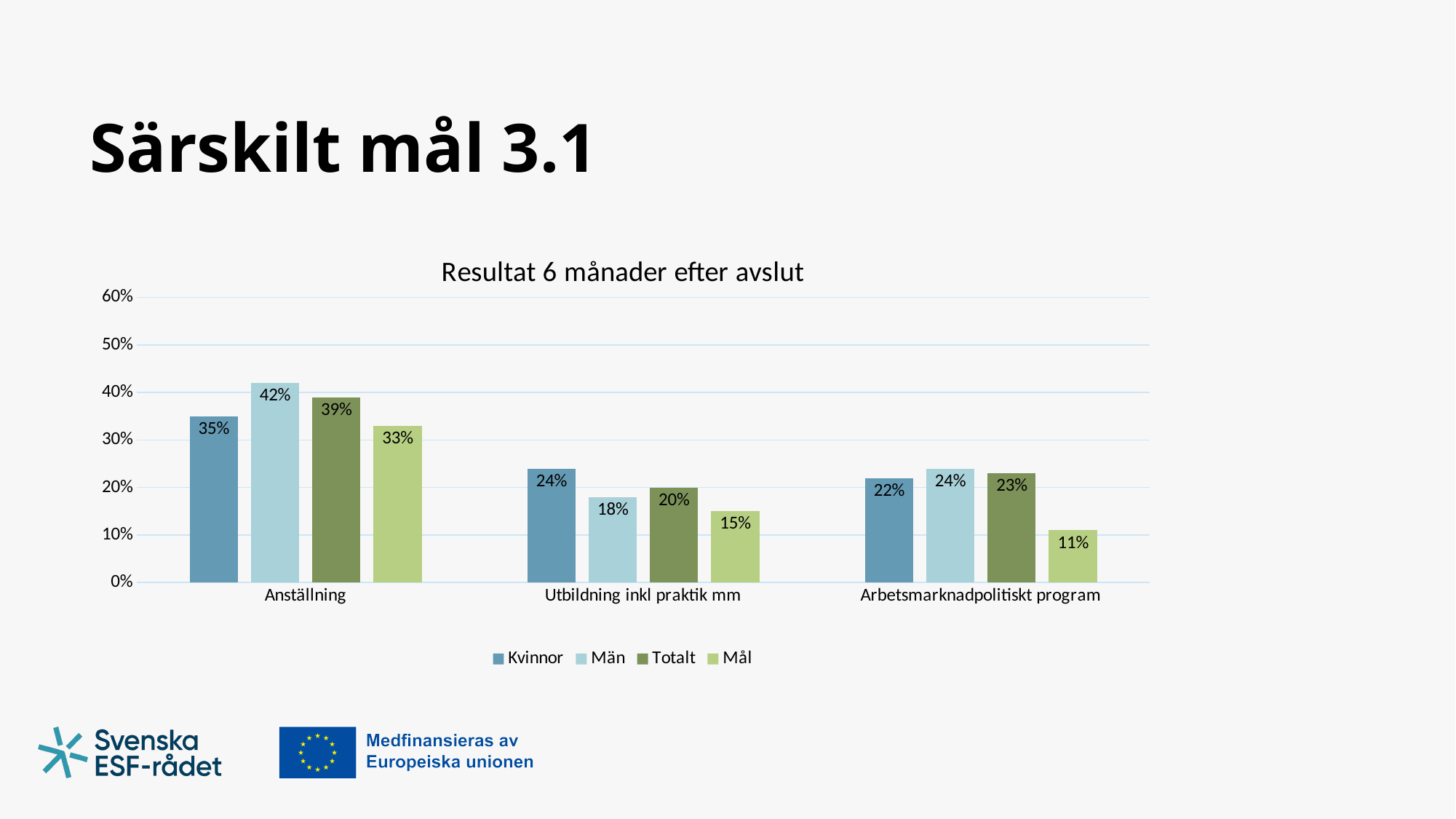
How many series does the legend list? 4 How many categories are shown on the x axis? 3 What is the difference between the Totalt and Mål values in the Arbetsmarknadpolitiskt program category? 12% What is the difference between the Män and Kvinnor values in the Anställning category? 7% What is the value for Totalt in the Arbetsmarknadpolitiskt program category? 23% What is the title of the chart? Resultat 6 månader efter avslut Which category has the lowest value for Mål? Arbetsmarknadpolitiskt program What kind of chart is shown on the slide? Bar chart What is the value for Kvinnor in the Anställning category? 35% In the Utbildning inkl praktik mm category, which is larger, Kvinnor or Män? Kvinnor Which category has the highest value for Män? Anställning What is the value for Mål in the Utbildning inkl praktik mm category? 15%